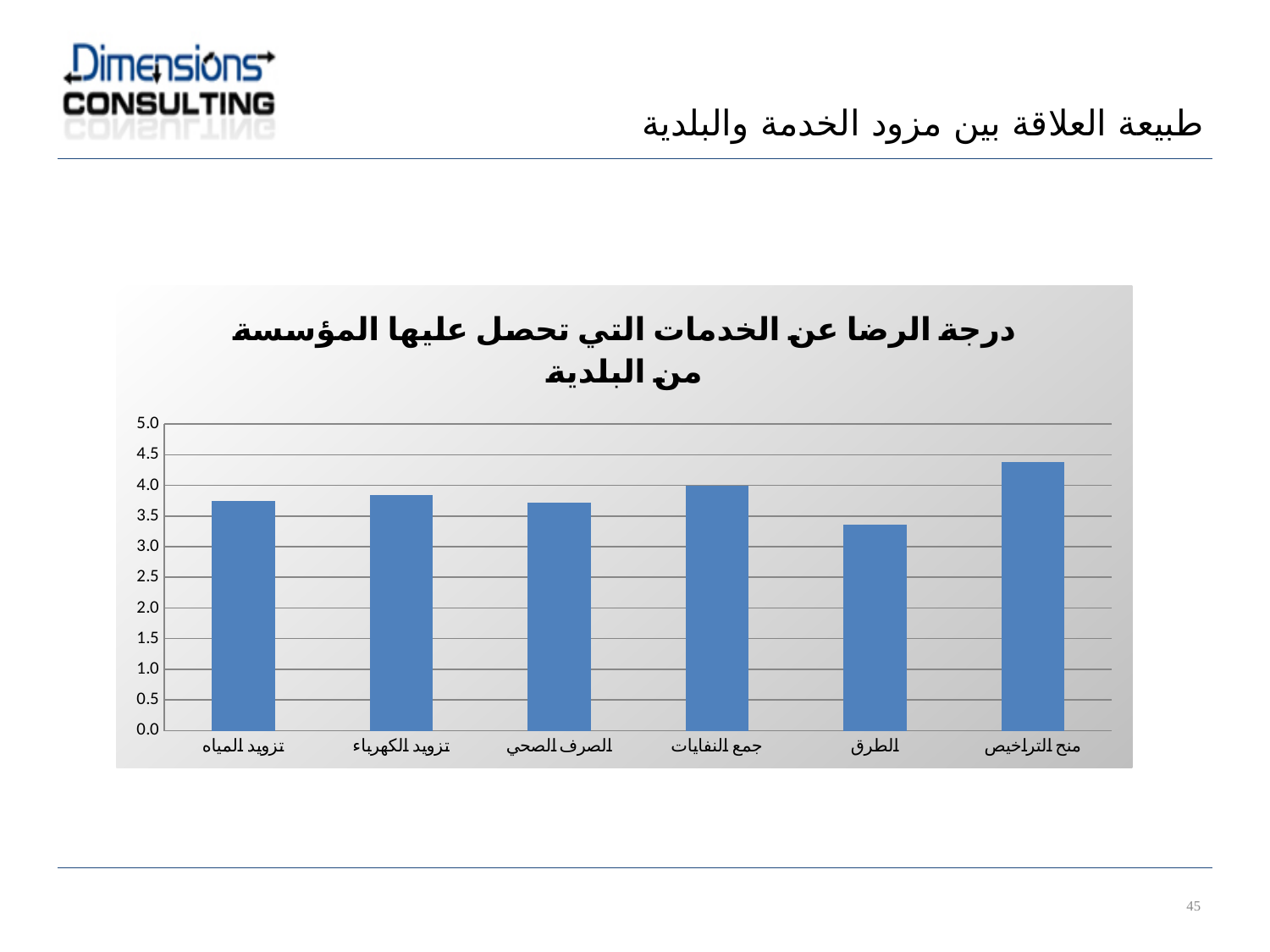
Is the value for تزويد المياه greater or less than 3.5? greater What kind of chart is shown on the slide? bar chart Is the value for منح التراخيص greater or less than 4.0? greater Is the value for الطرق greater or less than 3.5? less Which category has the lowest bar in the chart? الطرق How many categories are shown on the x axis of the chart? 6 Which category has the highest bar in the chart? منح التراخيص Which is larger, the value for جمع النفايات or the value for الطرق? جمع النفايات Which is larger, the value for منح التراخيص or the value for الطرق? منح التراخيص What colour are the bars in the chart? blue What is the title of the chart? درجة الرضا عن الخدمات التي تحصل عليها المؤسسة من البلدية